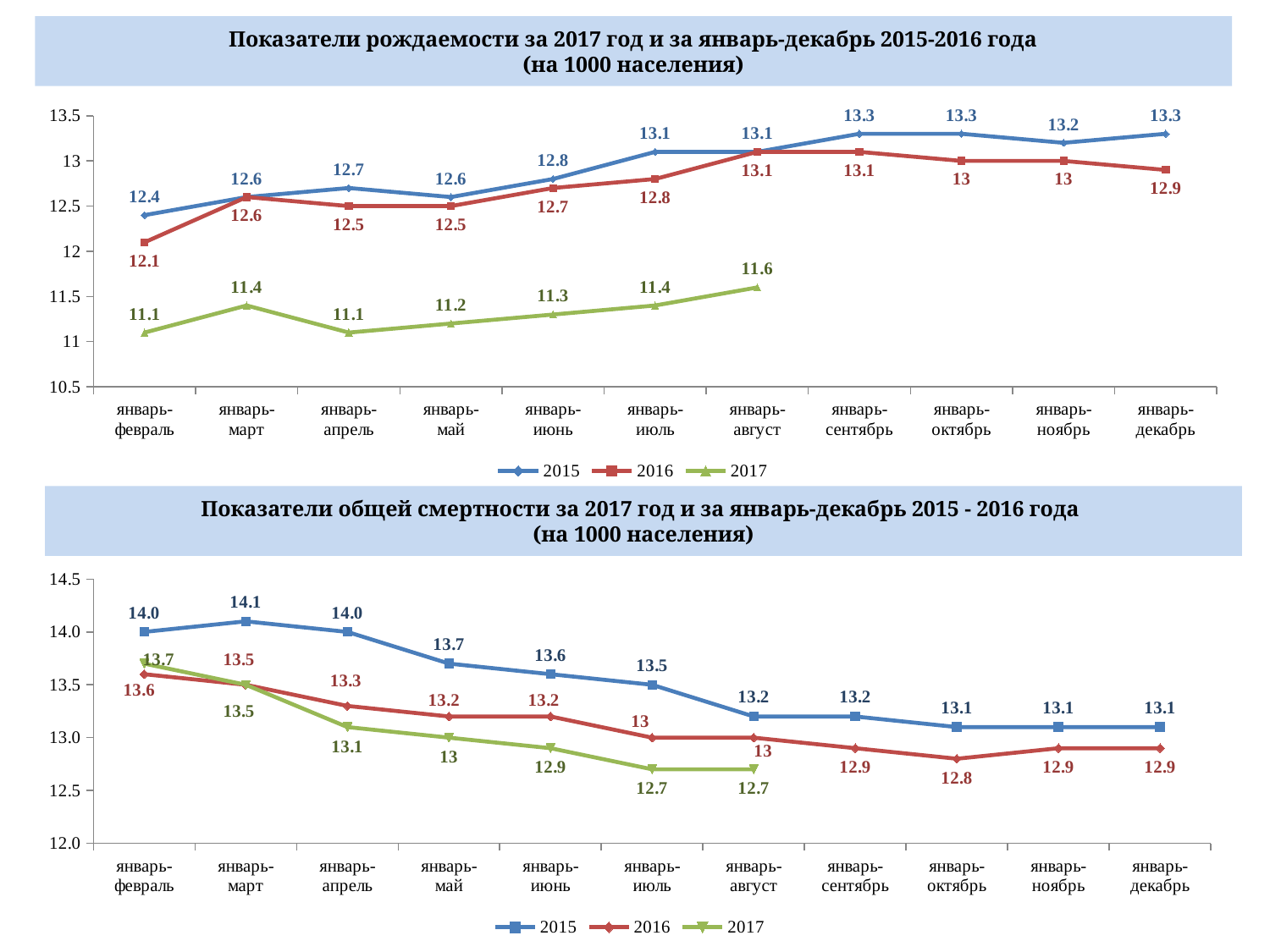
On the top chart (Показатели рождаемости), how many series does the legend list? 3 What kind of chart is the bottom chart (Показатели общей смертности)? line chart On the top chart (Показатели рождаемости), what is the 2017 value for январь-август? 11.6 On the bottom chart (Показатели общей смертности), what is the 2015 value for январь-март? 14.1 On the top chart (Показатели рождаемости), what is the 2016 value for январь-февраль? 12.1 On the bottom chart (Показатели общей смертности), do the 2017 values generally rise or fall from январь-февраль to январь-август? fall On the top chart (Показатели рождаемости), how many periods are shown on the x axis? 11 On the bottom chart (Показатели общей смертности), which is larger for январь-июль: the 2016 value or the 2017 value? 2016 On the top chart (Показатели рождаемости), what is the difference between the 2015 and 2017 values for январь-февраль? 1.3 On the bottom chart (Показатели общей смертности), what is the difference between the 2015 and 2016 values for январь-декабрь? 0.2 On the top chart (Показатели рождаемости), which series has the lowest values across all periods? 2017 On the bottom chart (Показатели общей смертности), which period has the highest 2015 value? январь-март